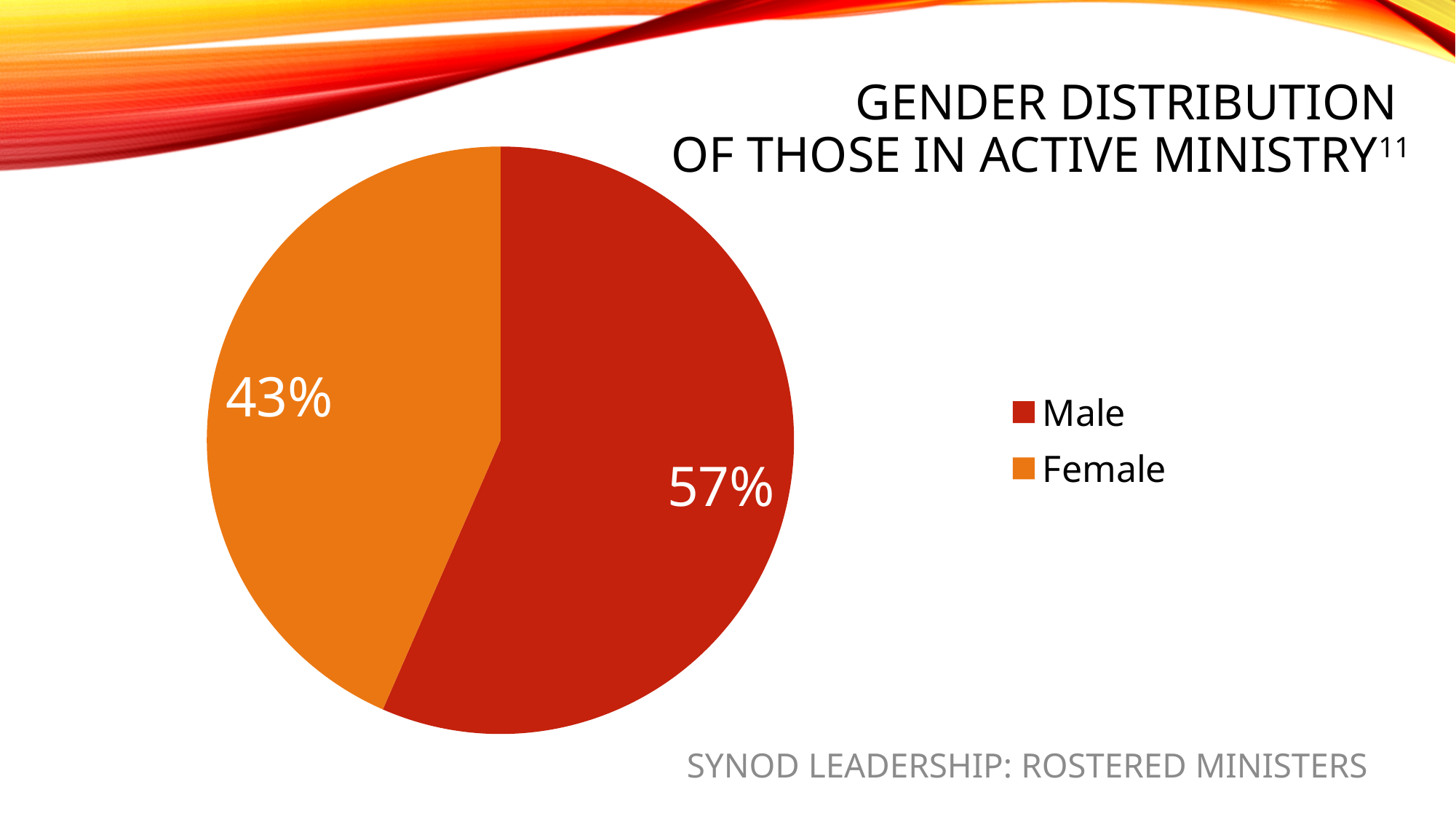
How many categories does the pie chart show? 2 Which is larger, the Male share or the Female share? Male Which category has the smallest share of the pie? Female What share of the pie is Female? 43% What is the title of the chart on the slide? Gender Distribution of Those in Active Ministry Which category has the largest share of the pie? Male What share of the pie is Male? 57% How many entries does the legend list? 2 What kind of chart is shown on the slide? pie chart What colour is the Female slice? orange What is the difference in percentage points between the Male and Female shares? 14